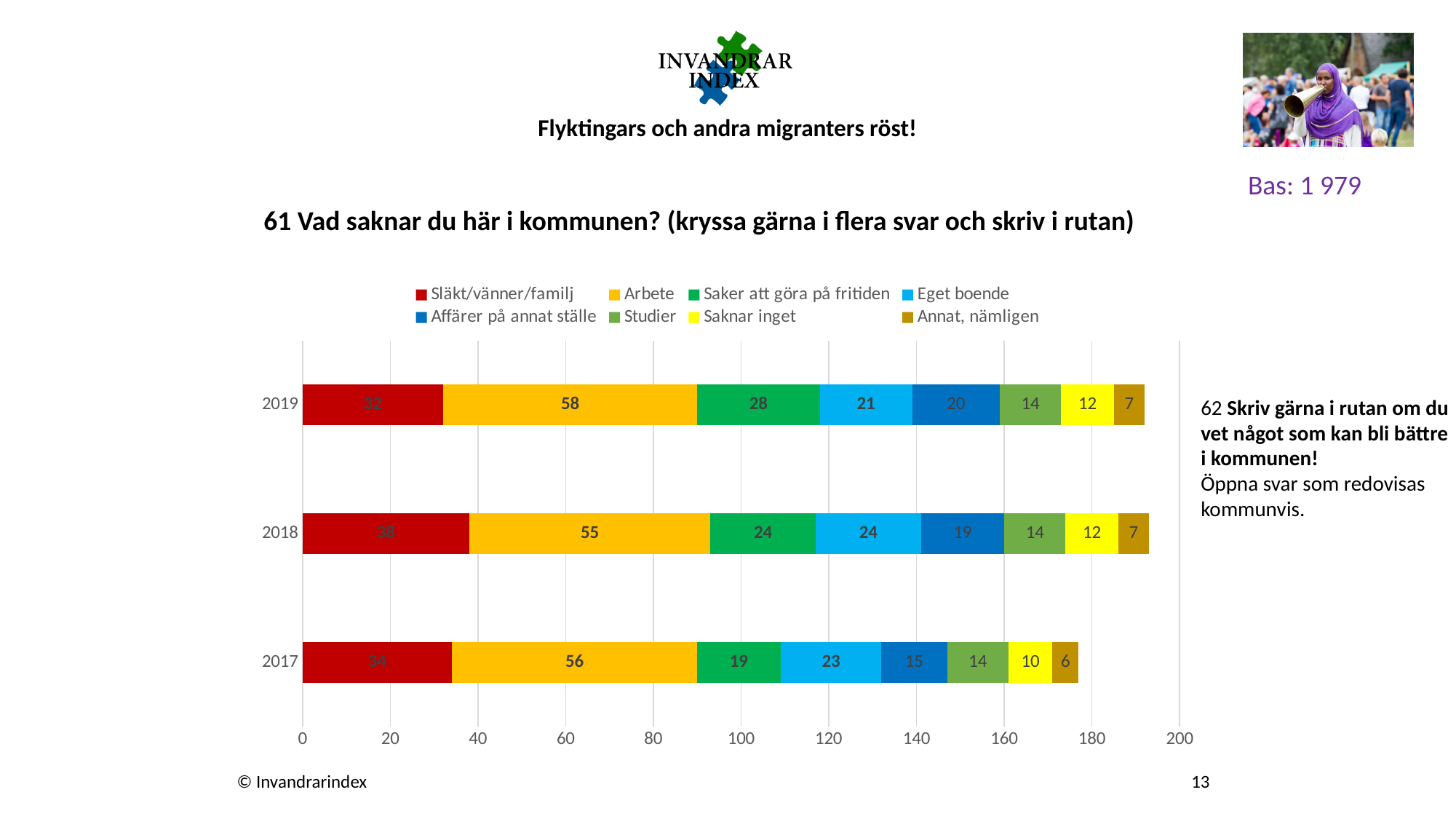
What is the value for Släkt/vänner/familj in 2018? 38 Which year has the highest value for Släkt/vänner/familj? 2018 What is the difference between the Saker att göra på fritiden values for 2019 and 2017? 9 Is the value for Eget boende larger in 2018 or in 2019? 2018 How many series does the legend list? 8 What is the value for Arbete in 2019? 58 What is the value for Saker att göra på fritiden in 2017? 19 What is the total of the stacked bar for 2017? 177 How many years (categories) are shown on the chart? 3 What kind of chart is shown on the slide? Stacked bar chart What is the value for Annat, nämligen in 2017? 6 Which year has the lowest value for Affärer på annat ställe? 2017